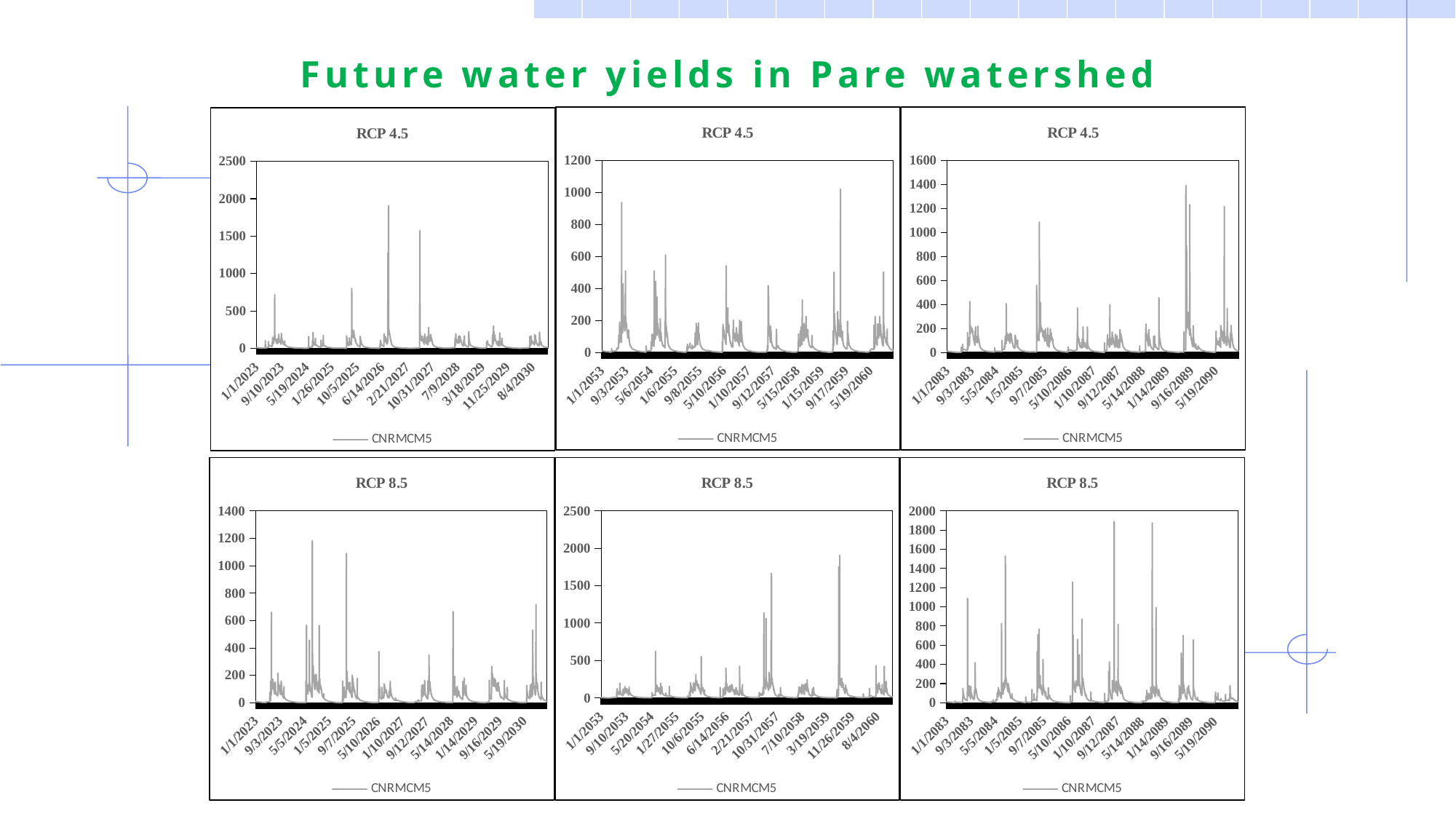
What kind of chart is the top-left RCP 4.5 chart? line chart In the top-middle RCP 4.5 chart (2053–2060), is the highest peak greater or less than 1200? less In the top-right RCP 4.5 chart (2083–2090), is the highest peak greater or less than 1200? greater What series name appears in the legend of the top-right RCP 4.5 chart? CNRMCM5 In the top-left RCP 4.5 chart (2023–2030), is the highest peak greater or less than 1500? greater How many series does the legend of the bottom-middle RCP 8.5 chart list? 1 What is the title of the bottom-left chart on the slide? RCP 8.5